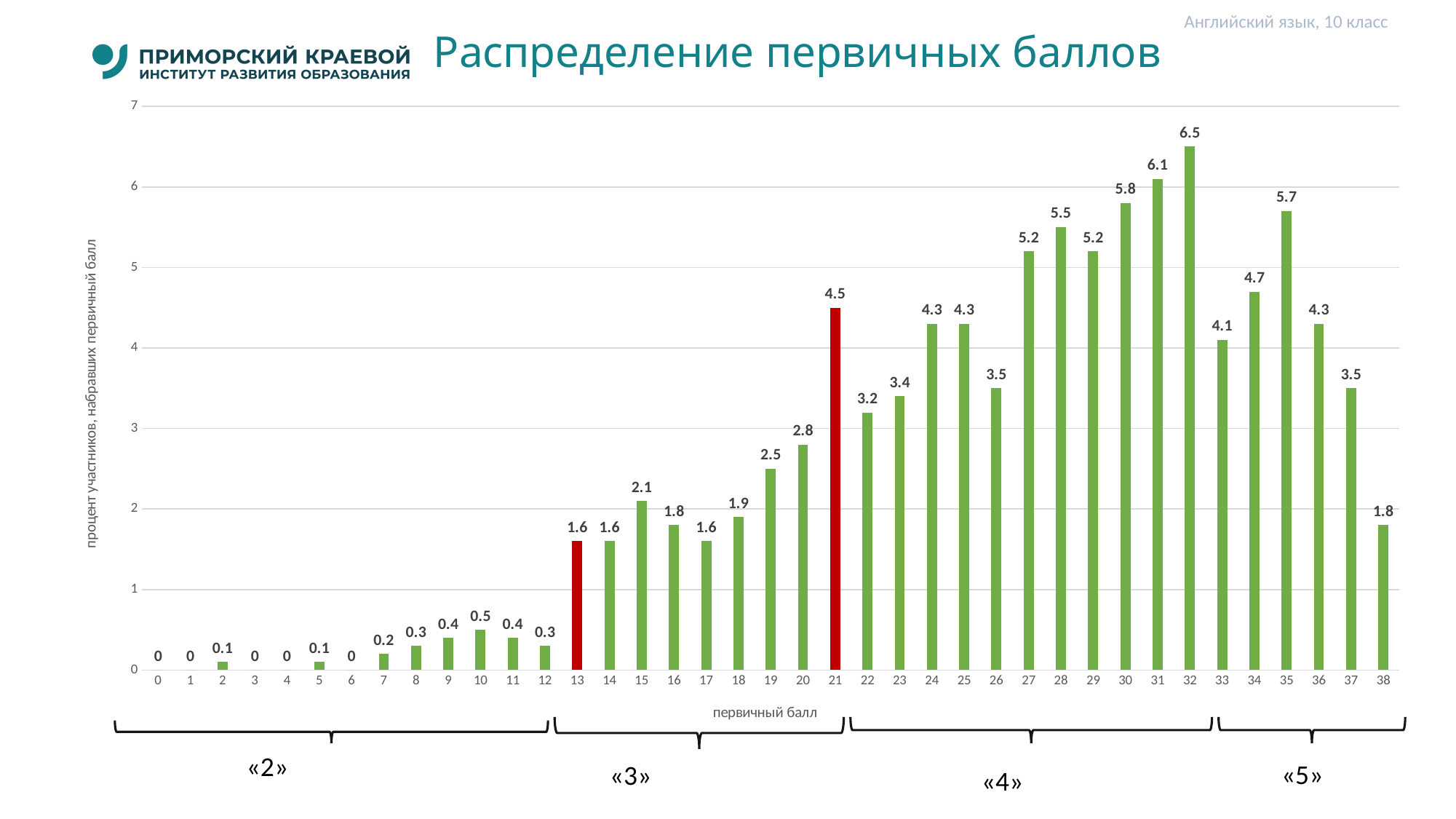
Which primary score has the highest value? 32 What is the title of the chart? Распределение первичных баллов Do the values generally rise or fall from primary score 13 to primary score 21? rise What is the difference between the values for primary scores 32 and 31? 0.4 Which is larger, the value for primary score 28 or for primary score 35? 35 What is the value for a primary score of 32? 6.5 What kind of chart is shown on the slide? bar chart Which two primary scores are shown with red bars? 13 and 21 Is the value for primary score 30 greater or less than 5? greater What is the value for a primary score of 38? 1.8 What is the value for a primary score of 21? 4.5 How many primary score categories are shown on the x axis? 39